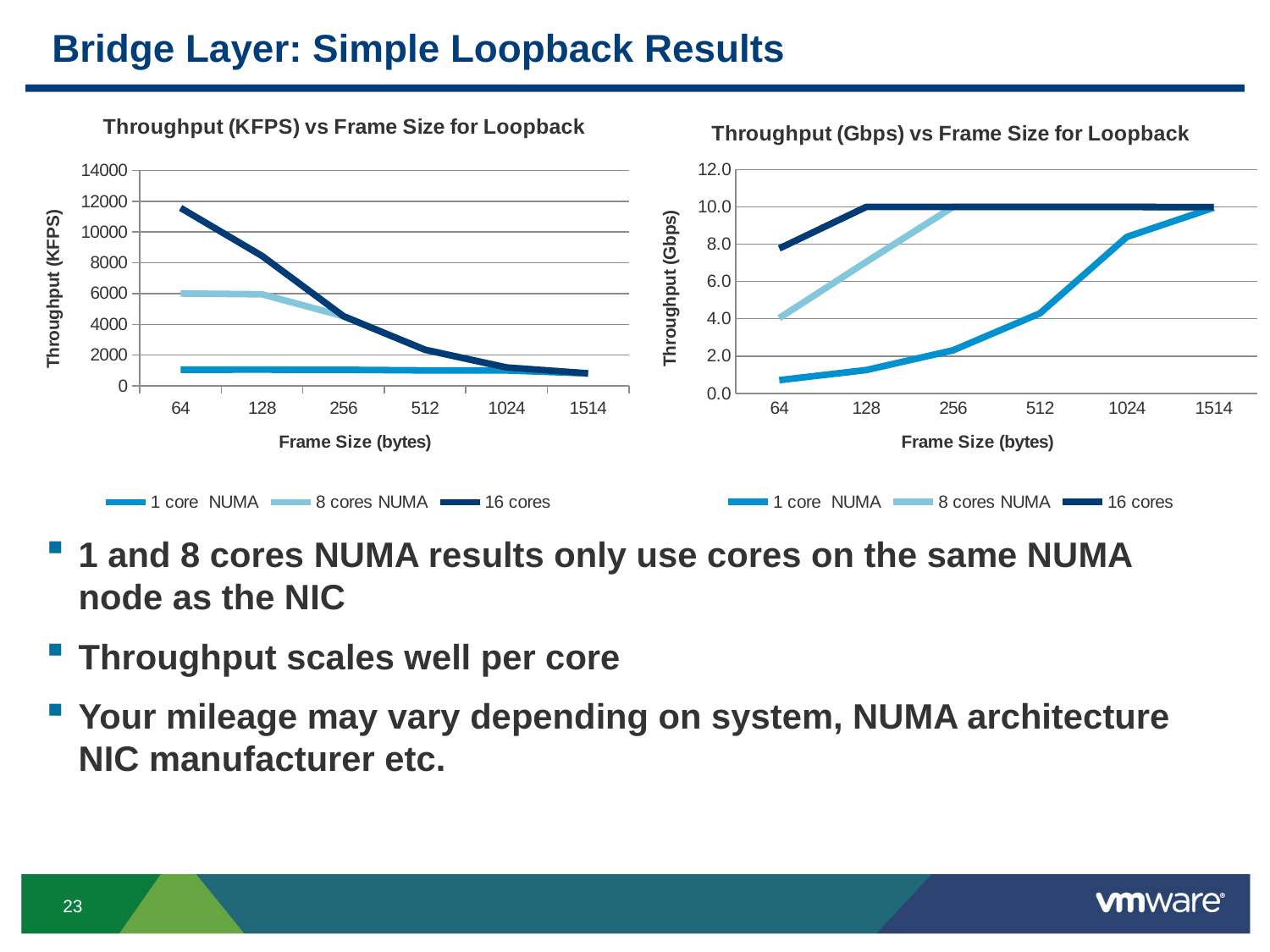
In the right chart, 'Throughput (Gbps) vs Frame Size for Loopback', is the value for 1 core NUMA at frame size 64 greater or less than 2.0? less How many series does the legend of the right chart, 'Throughput (Gbps) vs Frame Size for Loopback', list? 3 In the right chart, 'Throughput (Gbps) vs Frame Size for Loopback', does the 1 core NUMA series rise or fall as frame size increases? rise In the left chart, 'Throughput (KFPS) vs Frame Size for Loopback', which is larger at frame size 128: 16 cores or 1 core NUMA? 16 cores What is the x-axis label of the right chart, 'Throughput (Gbps) vs Frame Size for Loopback'? Frame Size (bytes) What kind of chart is the left chart, 'Throughput (KFPS) vs Frame Size for Loopback'? line chart In the left chart, 'Throughput (KFPS) vs Frame Size for Loopback', does the 16 cores series rise or fall as frame size increases? fall In the right chart, 'Throughput (Gbps) vs Frame Size for Loopback', which series has the highest value at frame size 64? 16 cores How many frame sizes are plotted along the x axis of the left chart, 'Throughput (KFPS) vs Frame Size for Loopback'? 6 In the left chart, 'Throughput (KFPS) vs Frame Size for Loopback', is the value for 1 core NUMA at frame size 64 greater or less than 2000? less In the right chart, 'Throughput (Gbps) vs Frame Size for Loopback', is the value for 8 cores NUMA at frame size 64 greater or less than 2.0? greater